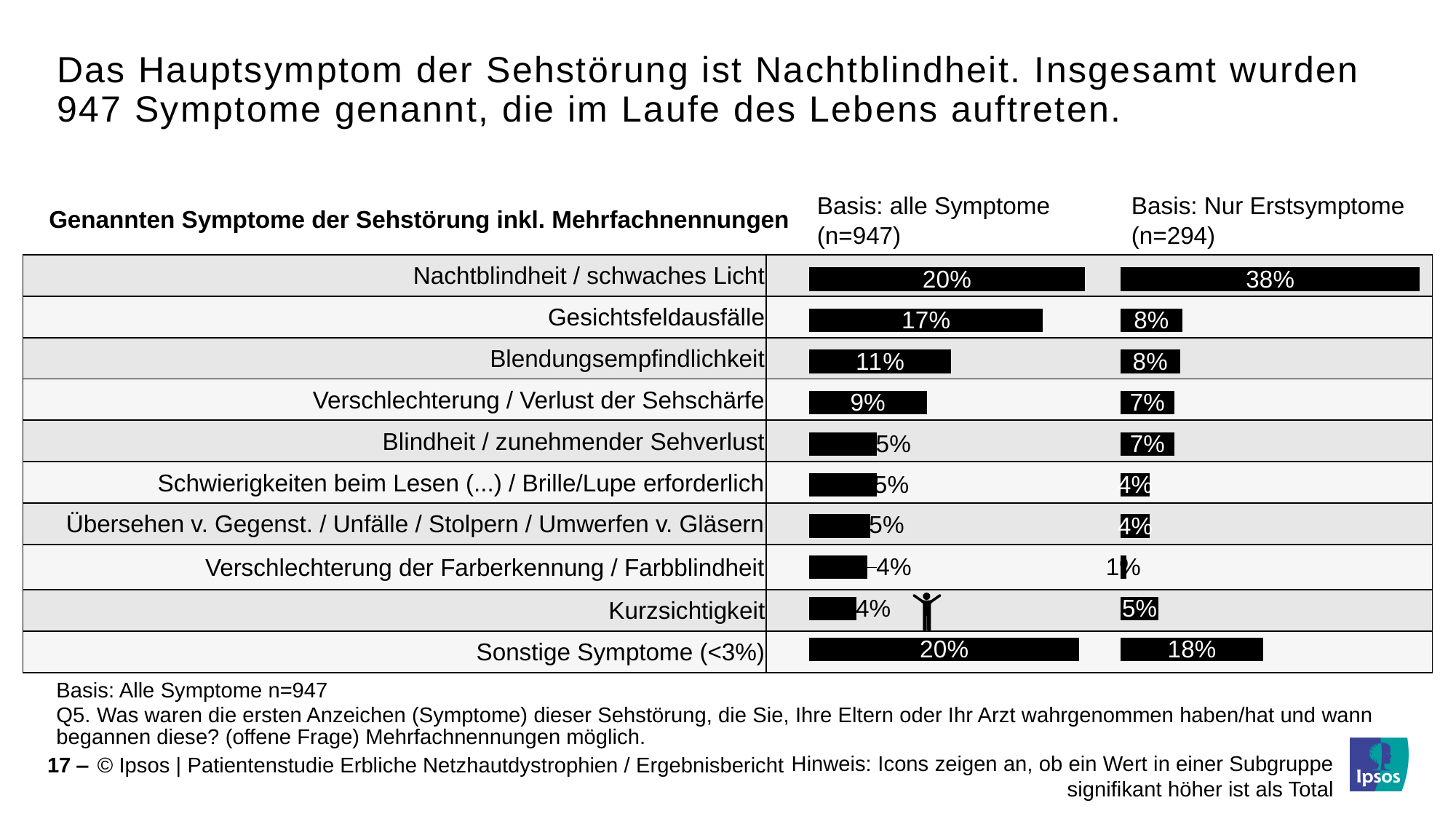
In the 'Basis: Nur Erstsymptome (n=294)' chart, what is the value for Sonstige Symptome (<3%)? 18% In the 'Basis: Nur Erstsymptome (n=294)' chart, which symptom has the lowest value? Verschlechterung der Farberkennung / Farbblindheit What type of chart is used to show the symptom values on this slide? Bar chart In the 'Basis: alle Symptome (n=947)' chart, what is the value for Gesichtsfeldausfälle? 17% In the 'Basis: Nur Erstsymptome (n=294)' chart, what is the value for Nachtblindheit / schwaches Licht? 38% In the 'Basis: Nur Erstsymptome (n=294)' chart, which symptom has the highest value? Nachtblindheit / schwaches Licht Which is larger: Gesichtsfeldausfälle in the 'Basis: alle Symptome (n=947)' chart or in the 'Basis: Nur Erstsymptome (n=294)' chart? Basis: alle Symptome (n=947) What is the difference between the Nachtblindheit / schwaches Licht values in the 'Basis: Nur Erstsymptome (n=294)' chart and the 'Basis: alle Symptome (n=947)' chart? 18 percentage points In the 'Basis: alle Symptome (n=947)' chart, what is the difference between Gesichtsfeldausfälle and Blendungsempfindlichkeit? 6 percentage points In the 'Basis: alle Symptome (n=947)' chart, what is the value for Verschlechterung / Verlust der Sehschärfe? 9% How many symptom categories are shown in the 'Basis: alle Symptome (n=947)' chart? 10 In the 'Basis: alle Symptome (n=947)' chart, what is the value for Nachtblindheit / schwaches Licht? 20%